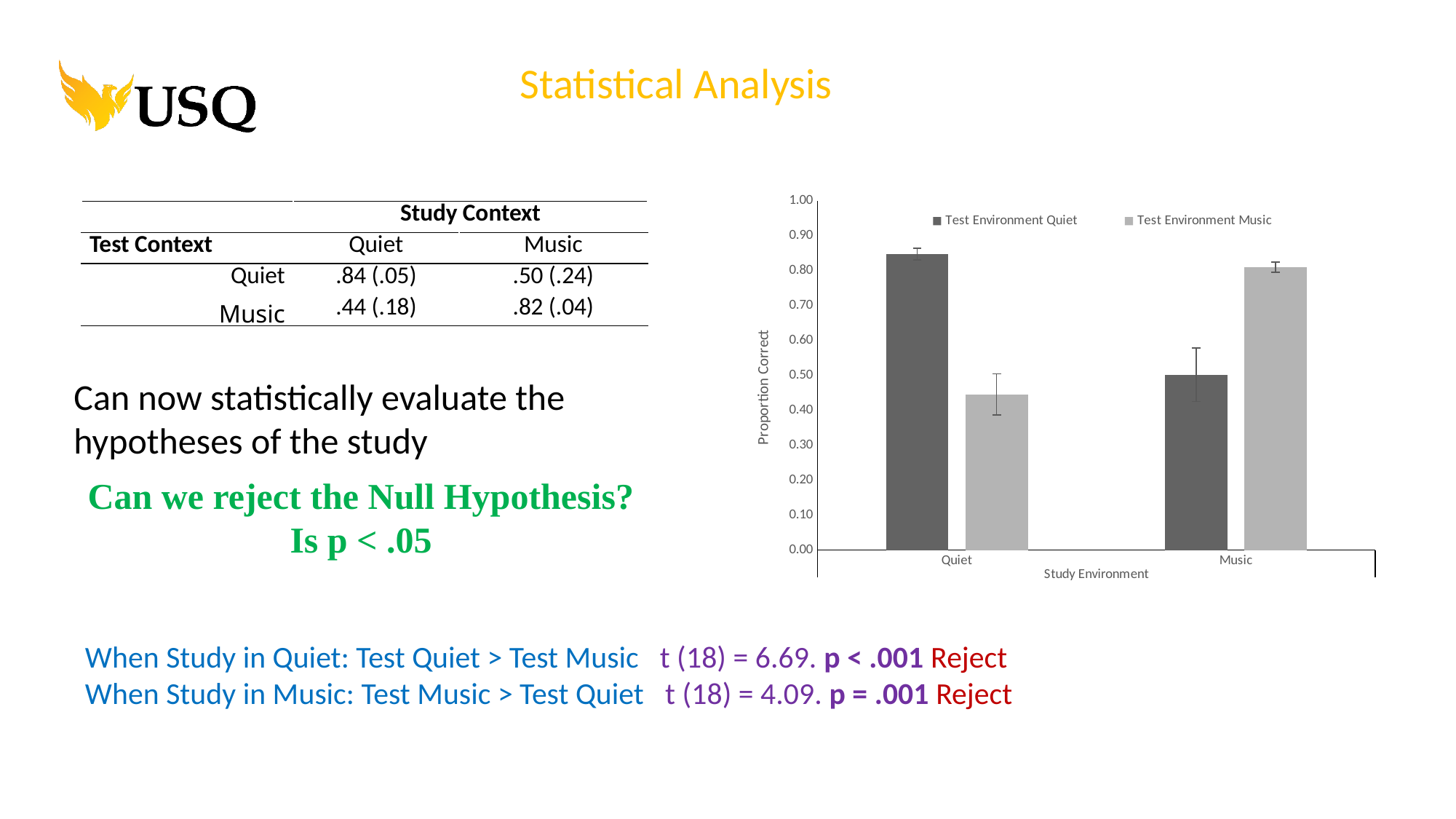
Is the value for Test Environment Music in the Music study environment greater or less than 0.70? greater Which bar in the chart has the lowest value? Test Environment Music in the Quiet study environment What kind of chart is shown on the slide? bar chart Is the value for Test Environment Music in the Quiet study environment greater or less than 0.50? less What are the two series named in the chart's legend? Test Environment Quiet and Test Environment Music In the Music study environment, which series has the larger value, Test Environment Quiet or Test Environment Music? Test Environment Music Is the value for Test Environment Quiet in the Quiet study environment greater or less than 0.80? greater How many study environment categories are shown on the x axis of the chart? 2 What is the label on the chart's y axis? Proportion Correct In the Quiet study environment, which series has the larger value, Test Environment Quiet or Test Environment Music? Test Environment Quiet How many series does the chart's legend list? 2